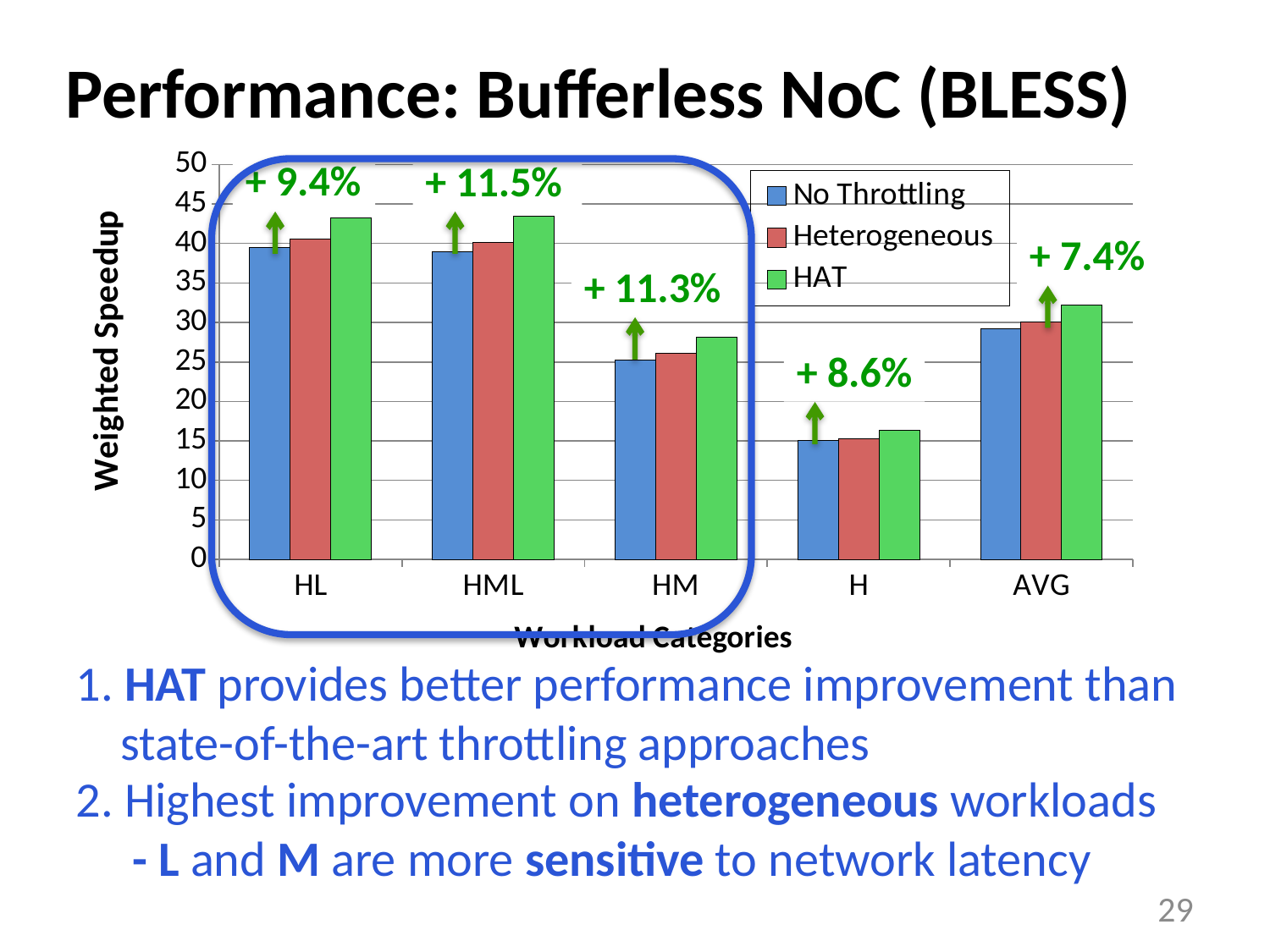
Is the No Throttling value for H greater or less than 20? less Which workload category has the lowest weighted speedup for HAT? H Is the HAT value for HM greater or less than 30? less How many series does the legend list? 3 What kind of chart is shown on the slide? bar chart How many workload categories are shown on the x axis? 5 What improvement percentage is annotated above the AVG category? + 7.4% Is the HAT value for HL greater or less than 40? greater Which has the larger No Throttling value, HM or H? HM What is the title of the y axis? Weighted Speedup What improvement percentage is annotated above the HML category? + 11.5% Which is larger for HM, the HAT bar or the No Throttling bar? HAT